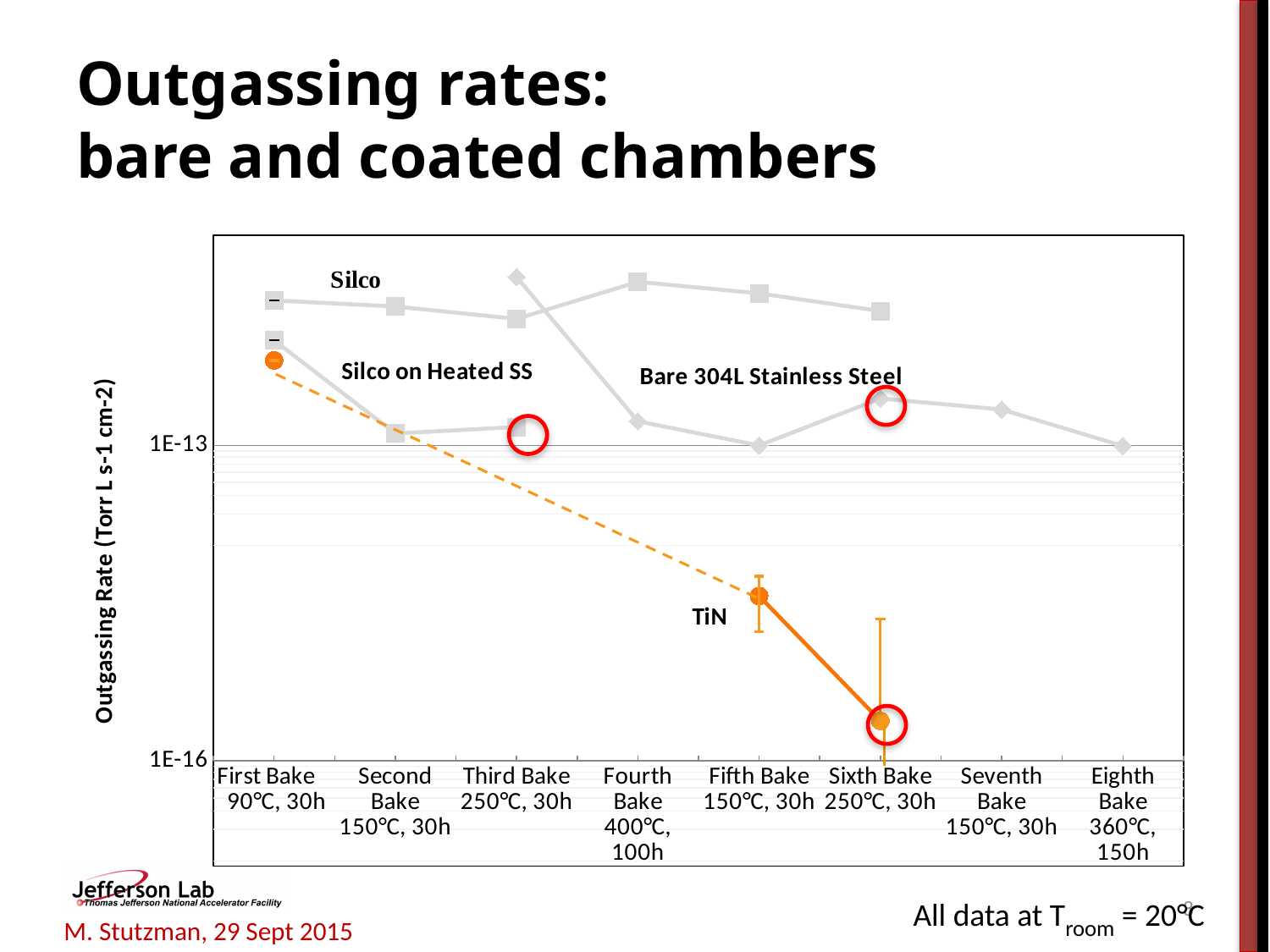
Which series is labeled with orange markers and an orange line? TiN Which series has the lowest value at Sixth Bake 250°C, 30h? TiN Is the Silco value at First Bake 90°C, 30h greater or less than 1E-13? greater Is the TiN value at Sixth Bake 250°C, 30h greater or less than 1E-13? less Does the TiN series rise or fall from First Bake to Sixth Bake? fall What is the y-axis label of the chart? Outgassing Rate (Torr L s-1 cm-2) Is the TiN value at Fifth Bake 150°C, 30h greater or less than 1E-13? less What kind of chart is shown on the slide? line chart How many data series are labeled on the chart? 4 How many bake categories are shown along the x axis? 8 At First Bake 90°C, 30h, which is higher: Silco or TiN? Silco